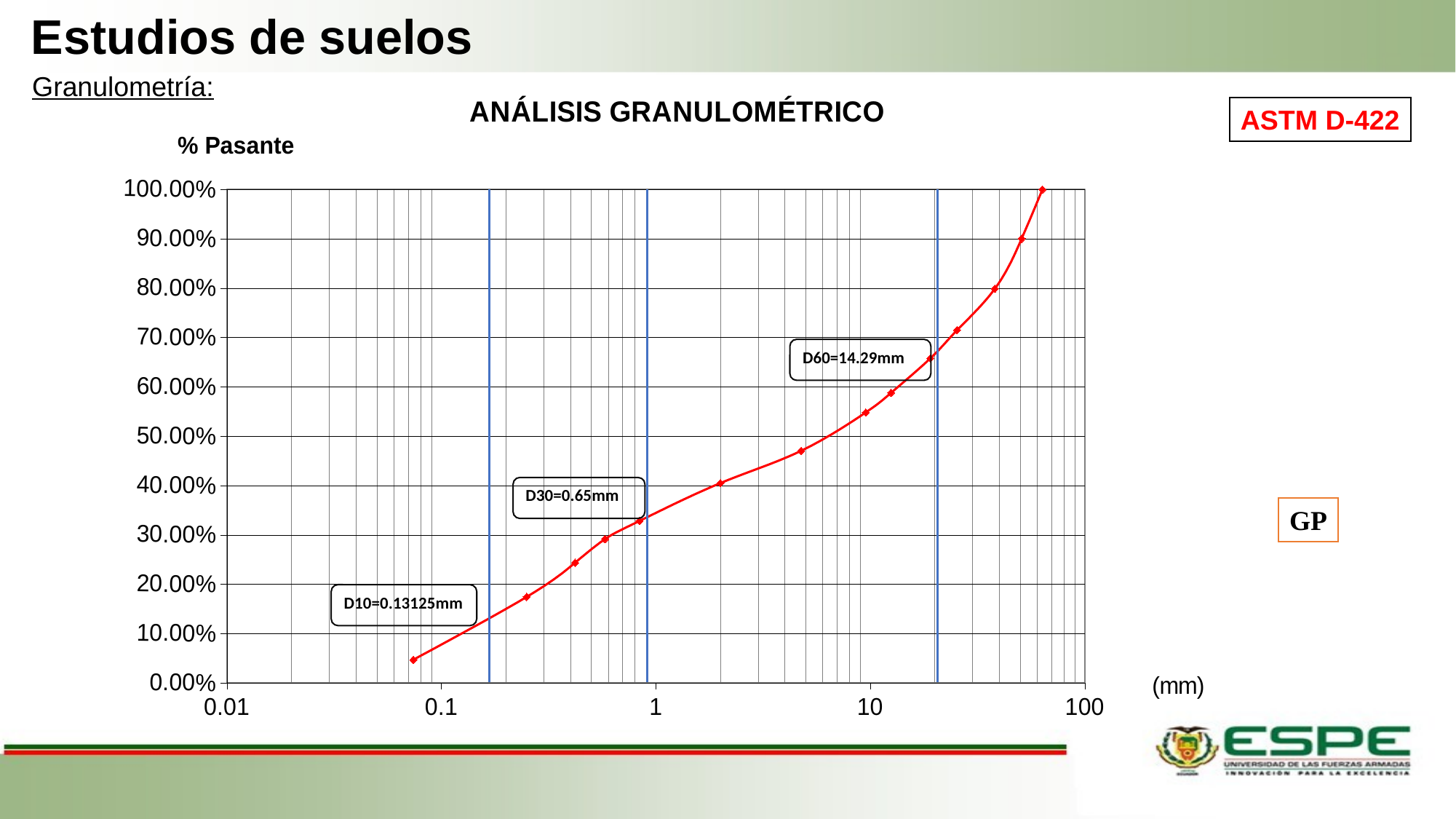
What is the title of the chart? ANÁLISIS GRANULOMÉTRICO Is the % Pasante value at 10 mm greater or less than 50.00%? greater Is the % Pasante value at 1 mm greater or less than 30.00%? greater Is the % Pasante value at 0.1 mm greater or less than 10.00%? less What kind of chart is shown on the slide? Line chart Does the % Pasante curve rise or fall as the particle size increases along the x axis? Rise What value of D60 is annotated on the chart? D60=14.29mm What is the highest % Pasante value reached by the curve? 100.00% What is the label of the vertical axis of the chart? % Pasante What value of D10 is annotated on the chart? D10=0.13125mm What value of D30 is annotated on the chart? D30=0.65mm